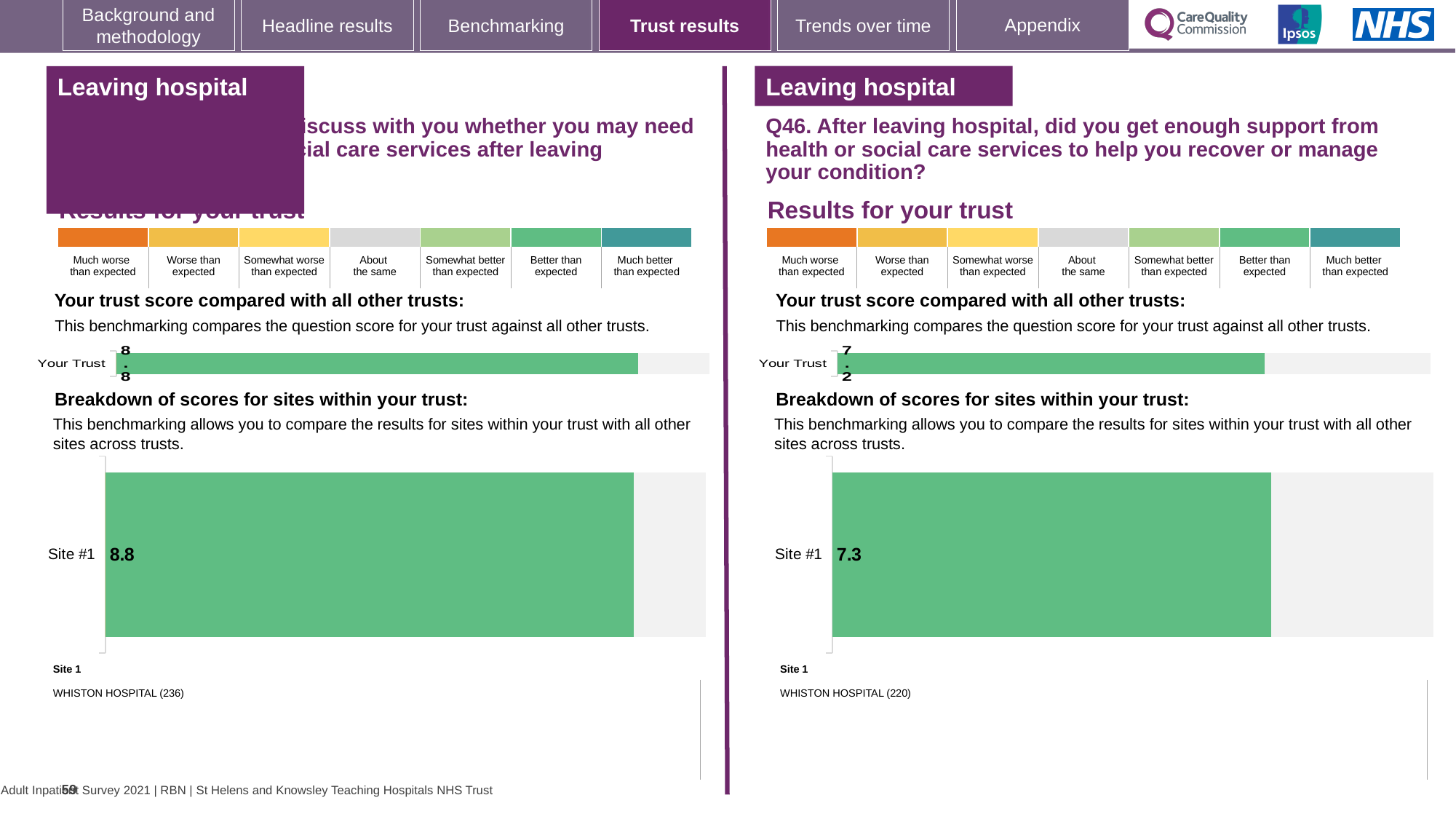
Is the Site #1 score in the right-hand (Q46) site breakdown chart greater or less than the Site #1 score in the left-hand site breakdown chart? Less How many sites are plotted in the right-hand 'Breakdown of scores for sites within your trust' chart? 1 Which is larger: the 'Your Trust' score on the left half of the slide or the 'Your Trust' score on the right half (Q46)? Left half (8.8) On the left half of the slide, what is the 'Your Trust' score shown in the trust benchmarking bar chart? 8.8 What colour is the bar for Site #1 in the left-hand site breakdown chart? Green In the right-hand (Q46) site breakdown chart, which site is plotted and what is its name given below the chart? Site #1, WHISTON HOSPITAL (220) What is the difference between the Site #1 score in the left-hand site breakdown chart and the Site #1 score in the right-hand (Q46) site breakdown chart? 1.5 What is the difference between the 'Your Trust' score on the left half of the slide and the 'Your Trust' score on the right half (Q46)? 1.6 What type of chart is used to show the 'Your Trust' score on the left half of the slide? Bar chart On the right half of the slide (Q46), what is the 'Your Trust' score shown in the trust benchmarking bar chart? 7.2 In the right-hand 'Breakdown of scores for sites within your trust' chart (Q46), what is the score for Site #1? 7.3 In the left-hand 'Breakdown of scores for sites within your trust' chart, what is the score for Site #1? 8.8